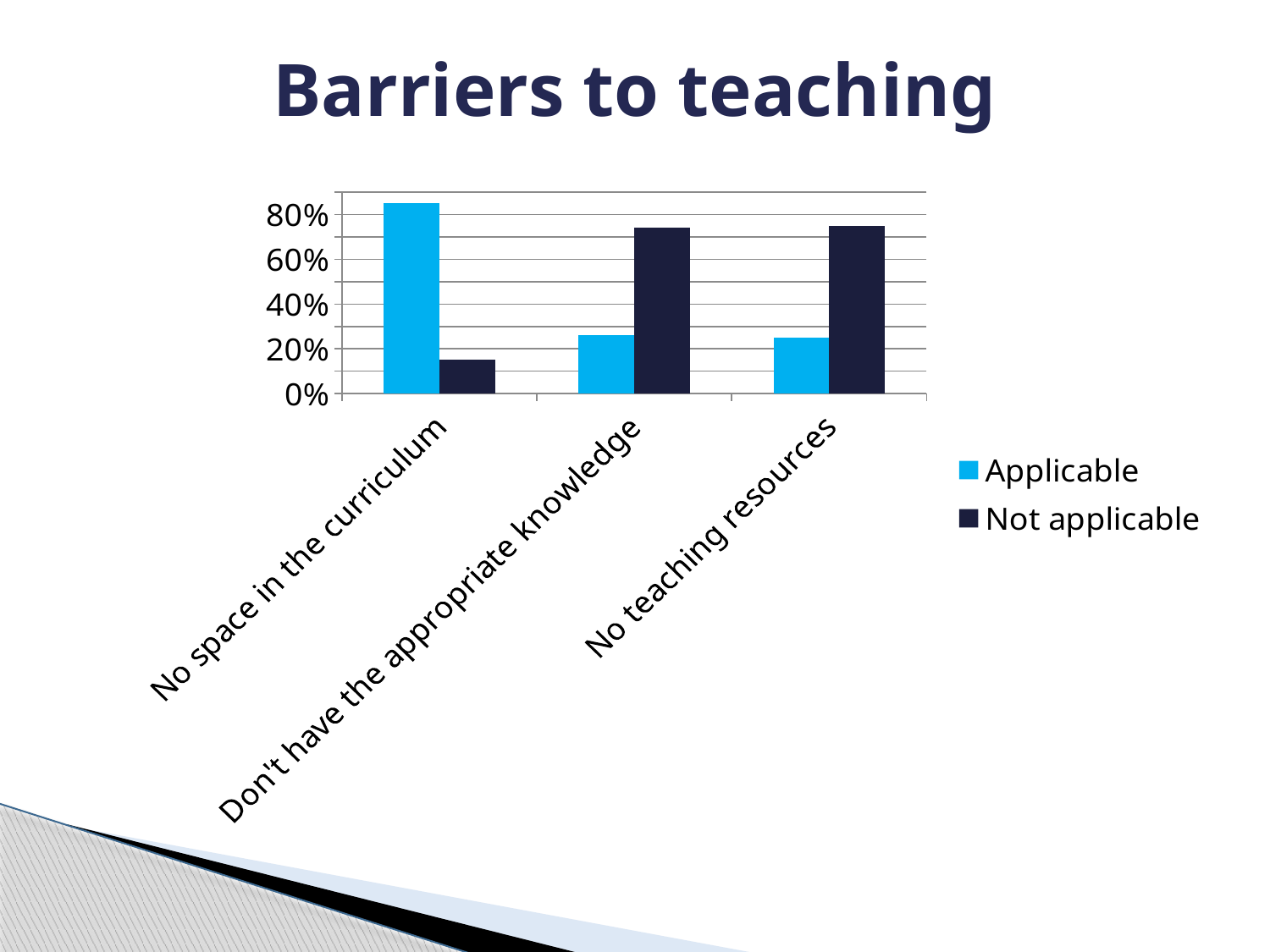
How many series does the legend list? 2 What is the title of the slide containing the chart? Barriers to teaching Which category has the lowest Not applicable value? No space in the curriculum What kind of chart is shown on the slide? bar chart Is the Applicable value for No space in the curriculum greater or less than 60%? greater Is the Applicable value for Don't have the appropriate knowledge greater or less than 40%? less Is the Not applicable value for No teaching resources greater or less than 60%? greater For No space in the curriculum, which is larger: Applicable or Not applicable? Applicable Which category has the highest Applicable value? No space in the curriculum How many categories are shown on the x axis of the chart? 3 For No teaching resources, which is larger: Applicable or Not applicable? Not applicable